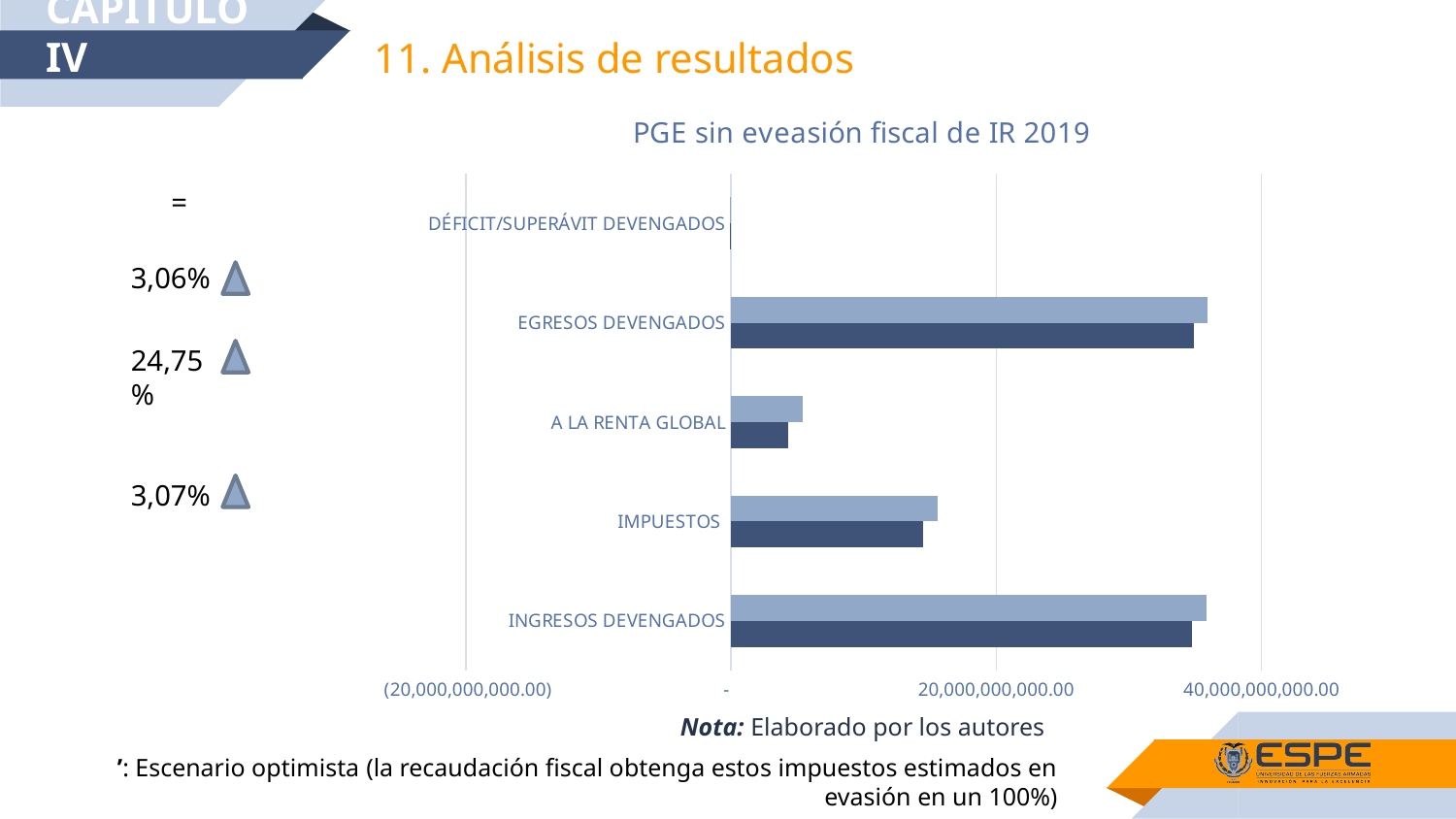
Is the value of the light blue bar for EGRESOS DEVENGADOS greater or less than 20,000,000,000.00? greater How many bars are drawn for each category on the chart? 2 Which has the larger light blue bar, IMPUESTOS or A LA RENTA GLOBAL? IMPUESTOS Is the value of the dark blue bar for A LA RENTA GLOBAL greater or less than 20,000,000,000.00? less What kind of chart is shown on the slide? bar chart Is the value of the light blue bar for EGRESOS DEVENGADOS greater or less than 40,000,000,000.00? less What is the title of the chart? PGE sin eveasión fiscal de IR 2019 How many categories are shown on the chart's vertical axis? 5 Which has the larger dark blue bar, EGRESOS DEVENGADOS or IMPUESTOS? EGRESOS DEVENGADOS Which category has the lowest values on the chart? DÉFICIT/SUPERÁVIT DEVENGADOS